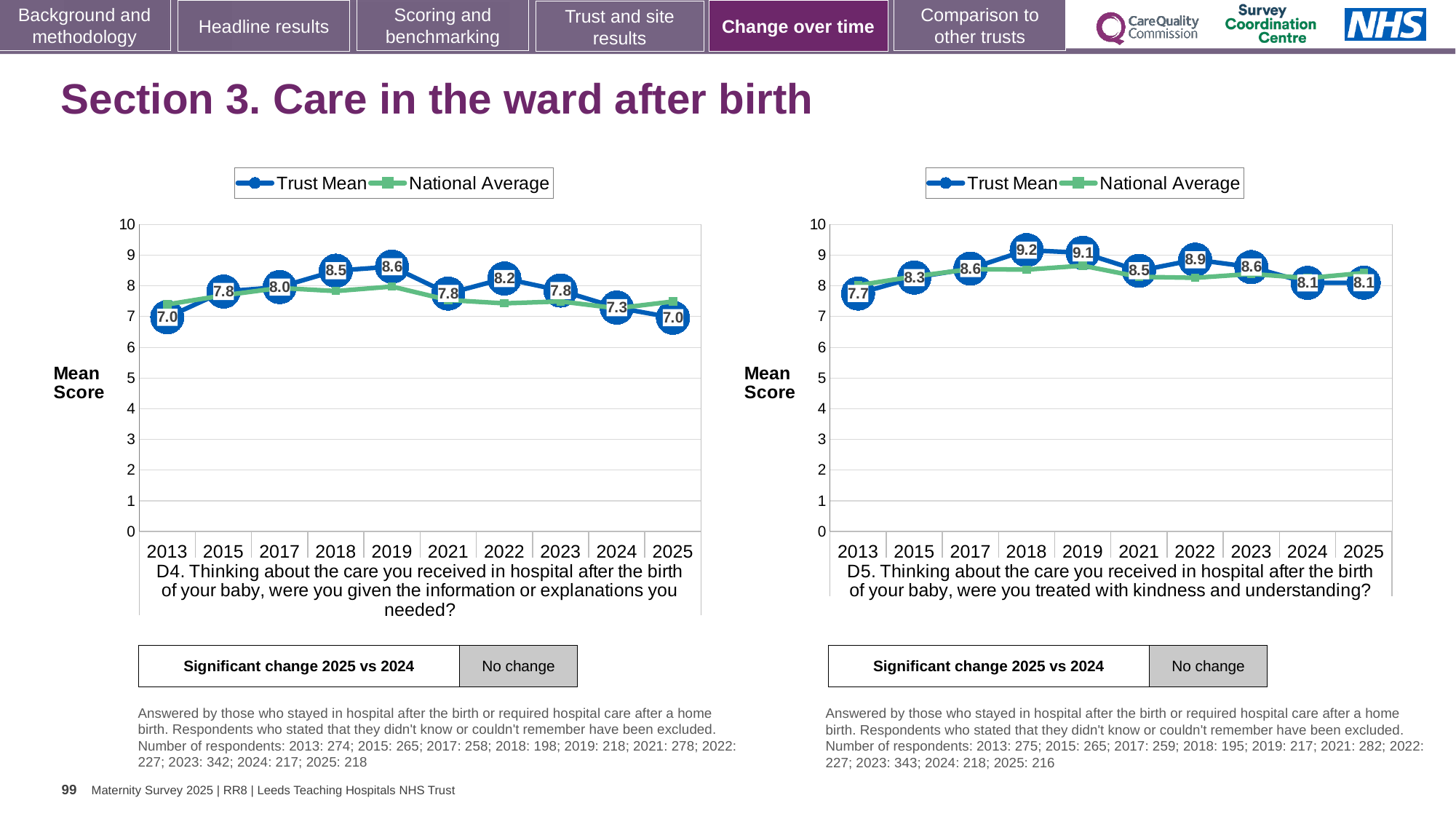
In the D5 chart on the right, what is the Trust Mean score for 2013? 7.7 How many series does the legend of the D4 chart on the left list? 2 In the D5 chart on the right, what is the difference between the Trust Mean scores for 2018 and 2025? 1.1 How many years are shown on the x axis of the D5 chart on the right? 10 In the D4 chart on the left, is the National Average for 2025 greater or less than 7? greater In the D4 chart on the left, what is the Trust Mean score for 2025? 7.0 In the D4 chart on the left, which year has the highest Trust Mean score? 2019 In the D5 chart on the right, what is the Trust Mean score for 2018? 9.2 In the D5 chart on the right, which year has the lowest Trust Mean score? 2013 What kind of chart is the D5 chart on the right? Line chart In the D4 chart on the left, which is larger, the Trust Mean score for 2018 or for 2024? 2018 In the D4 chart on the left, what is the Trust Mean score for 2019? 8.6